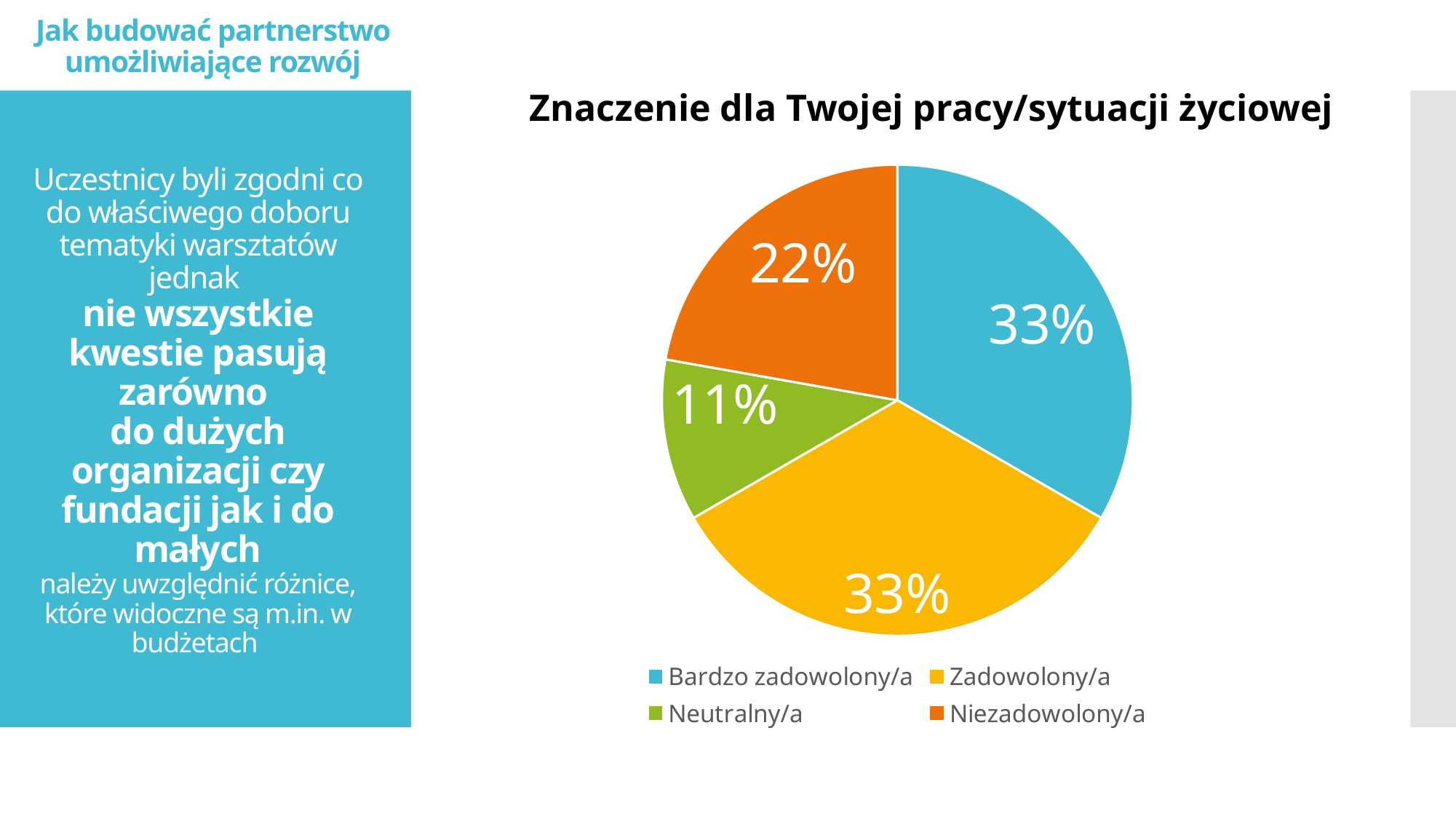
What is the difference in percentage points between the Niezadowolony/a slice and the Neutralny/a slice? 11 What kind of chart is shown on the slide? pie chart Which legend entry is shown in green? Neutralny/a What share of the pie is labelled Zadowolony/a? 33% What share of the pie is labelled Neutralny/a? 11% What share of the pie is labelled Bardzo zadowolony/a? 33% Which category has the smallest slice of the pie? Neutralny/a Which slice is larger, Niezadowolony/a or Neutralny/a? Niezadowolony/a Which slice is larger, Bardzo zadowolony/a or Niezadowolony/a? Bardzo zadowolony/a How many categories does the pie chart have? 4 What is the chart's title? Znaczenie dla Twojej pracy/sytuacji życiowej